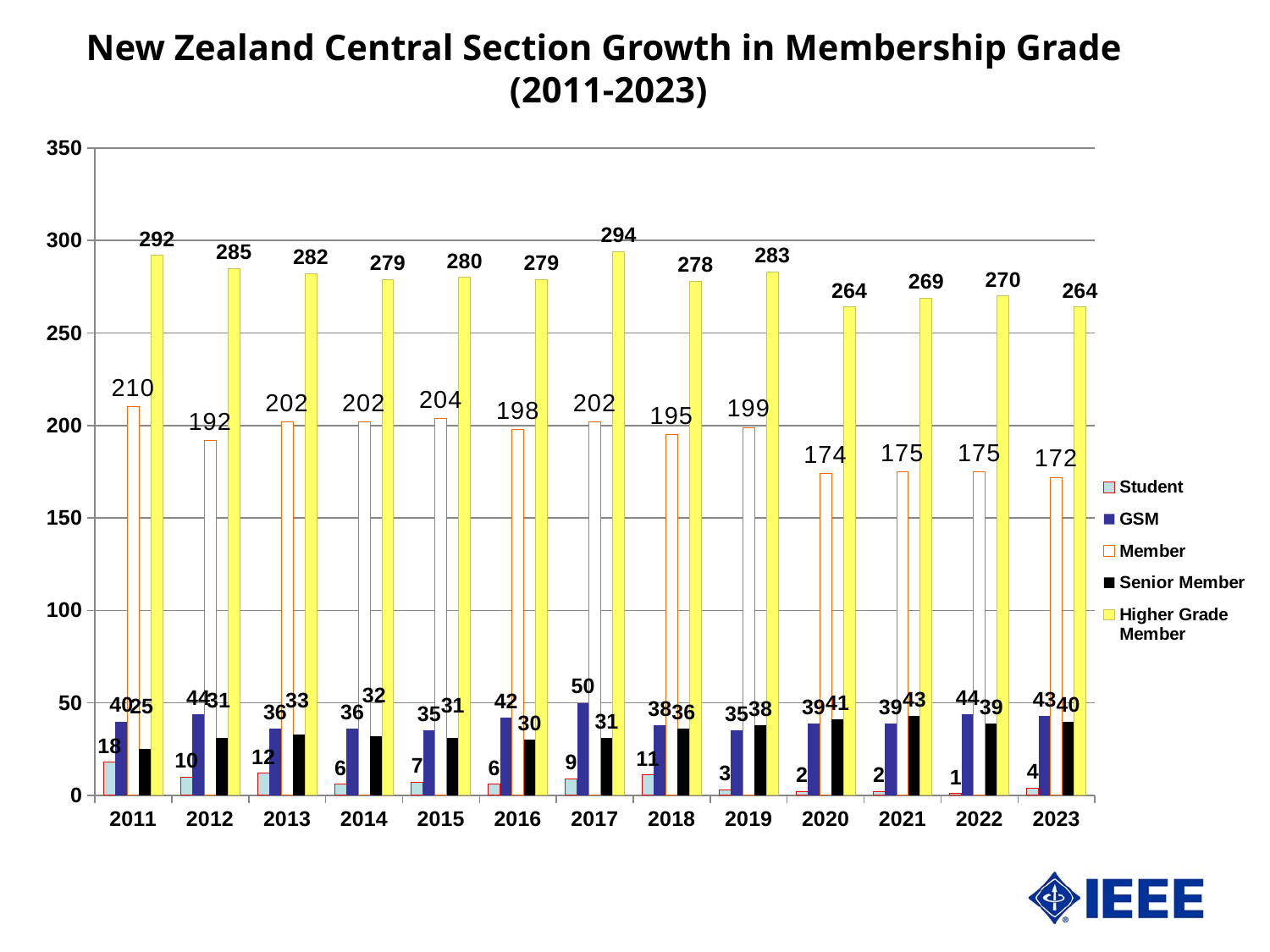
What is the Higher Grade Member value for 2017? 294 In which year is the Student value lowest? 2022 How many years are shown along the x axis? 13 How many series does the legend list? 5 What is the Member value for 2011? 210 In which year is the Higher Grade Member value highest? 2017 Which series is shown in yellow? Higher Grade Member What kind of chart is shown on the slide? bar chart What is the difference between the Higher Grade Member values for 2011 and 2023? 28 Is the Member value for 2020 greater or less than 200? less Do the Member values generally rise or fall from 2011 to 2023? fall Which year has the larger Member value, 2012 or 2013? 2013